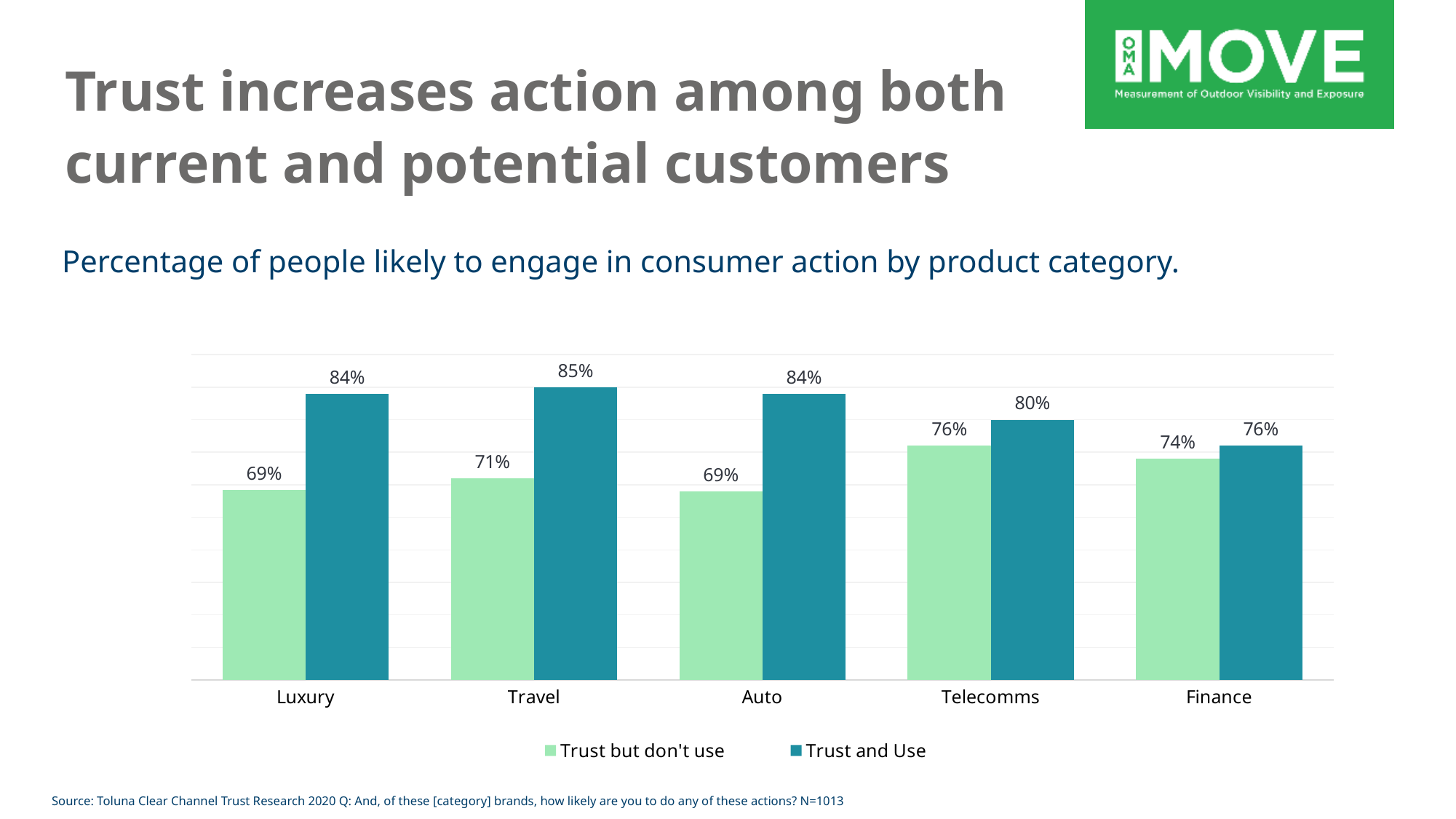
Which category has the highest Trust and Use value? Travel Which is larger, the Trust but don't use value for Telecomms or for Auto? Telecomms What is the difference between Trust and Use and Trust but don't use for Luxury? 15% How many series does the legend list? 2 How many product categories are shown on the x axis? 5 What is the value for Trust but don't use in the Finance category? 74% Which series is shown in the darker teal colour? Trust and Use What is the value for Trust and Use in the Travel category? 85% What kind of chart is shown on the slide? Bar chart What is the difference between Trust and Use and Trust but don't use for Finance? 2% What is the value for Trust but don't use in the Telecomms category? 76% Which category has the lowest Trust and Use value? Finance